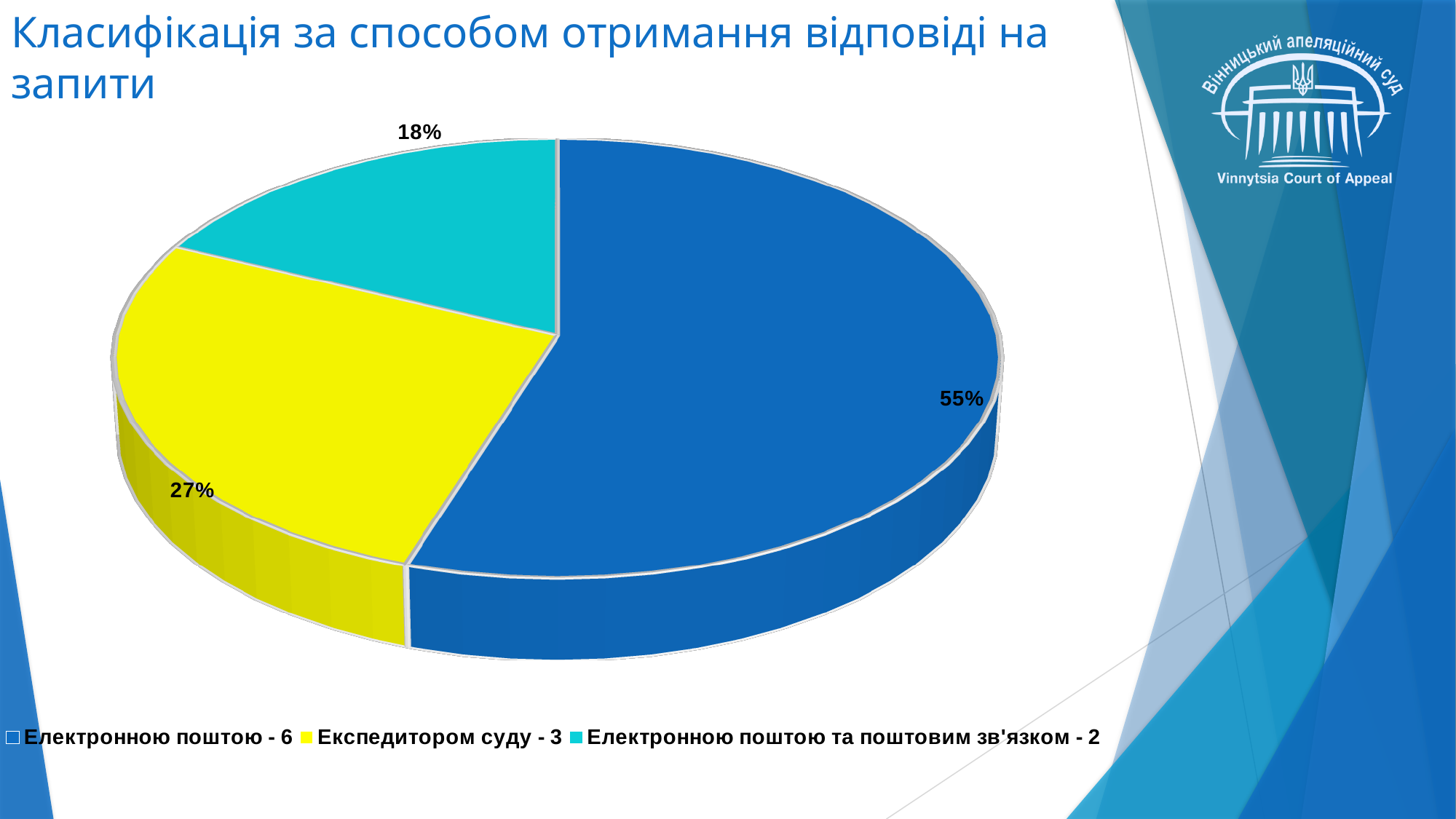
What percentage share does the slice "Експедитором суду - 3" have? 27% What is the difference in percentage points between the "Електронною поштою - 6" slice and the "Експедитором суду - 3" slice? 28 What percentage share does the slice "Електронною поштою - 6" have? 55% What kind of chart is shown on the slide? pie chart Which slice is larger: "Експедитором суду - 3" or "Електронною поштою та поштовим зв'язком - 2"? Експедитором суду - 3 How many slices does the pie chart have? 3 Which category has the smallest slice of the pie? Електронною поштою та поштовим зв'язком - 2 What colour is the slice for "Експедитором суду - 3"? yellow Which category has the largest slice of the pie? Електронною поштою - 6 What is the title of the slide containing the pie chart? Класифікація за способом отримання відповіді на запити What is the difference in percentage points between the "Експедитором суду - 3" slice and the "Електронною поштою та поштовим зв'язком - 2" slice? 9 What percentage share does the slice "Електронною поштою та поштовим зв'язком - 2" have? 18%